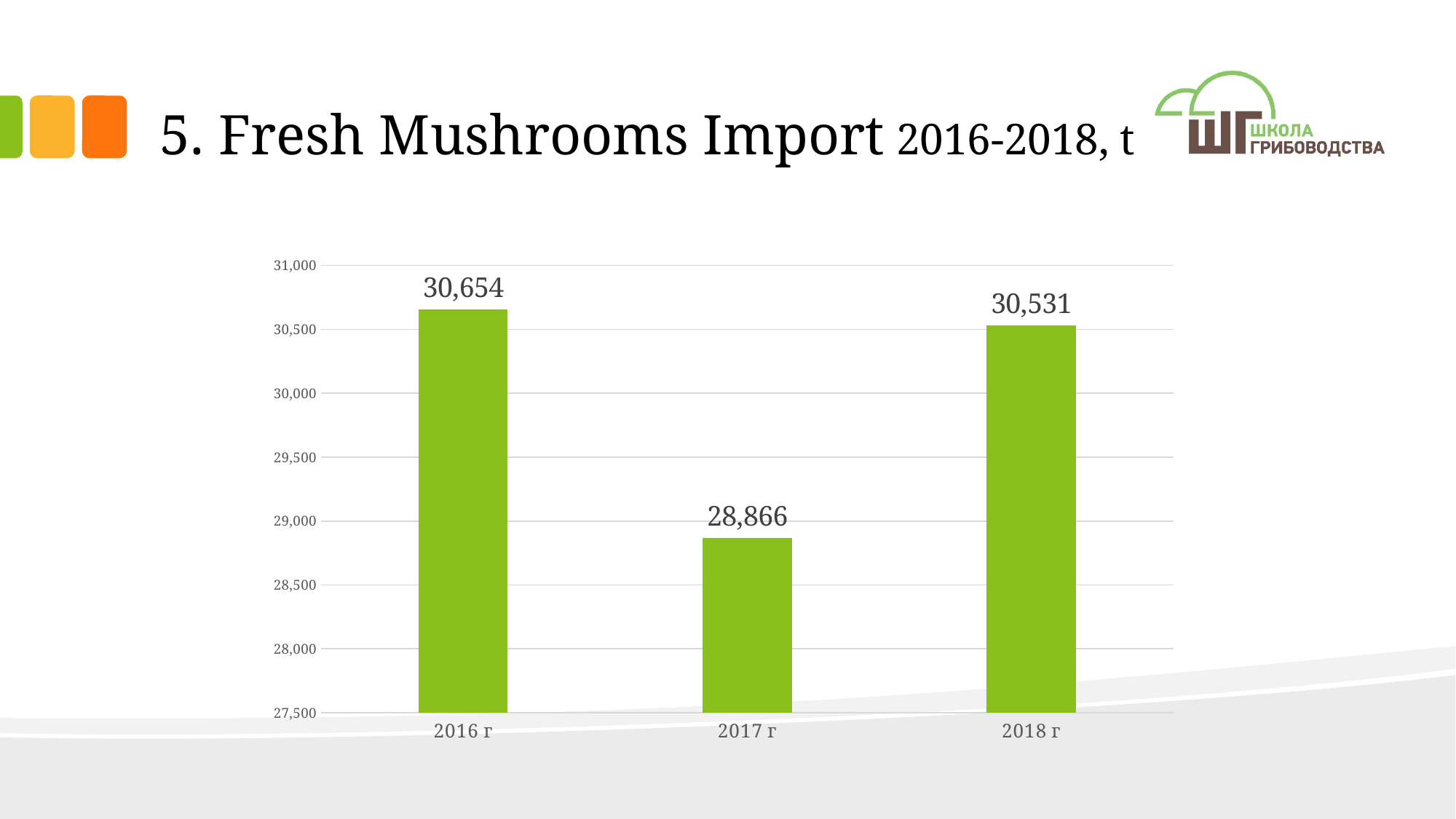
What is the difference between the import values for 2016 and 2018? 123 What is the difference between the import values for 2016 and 2017? 1,788 What is the fresh mushrooms import value for 2017? 28,866 What kind of chart is shown on the slide? bar chart What is the title of the slide? 5. Fresh Mushrooms Import 2016-2018, t Which is larger, the import value for 2017 or for 2018? 2018 What is the fresh mushrooms import value for 2018? 30,531 How many years are shown on the chart? 3 What is the fresh mushrooms import value for 2016? 30,654 Which year has the lowest fresh mushrooms import? 2017 Is the import value for 2017 greater or less than 29,000? less Which year has the highest fresh mushrooms import? 2016